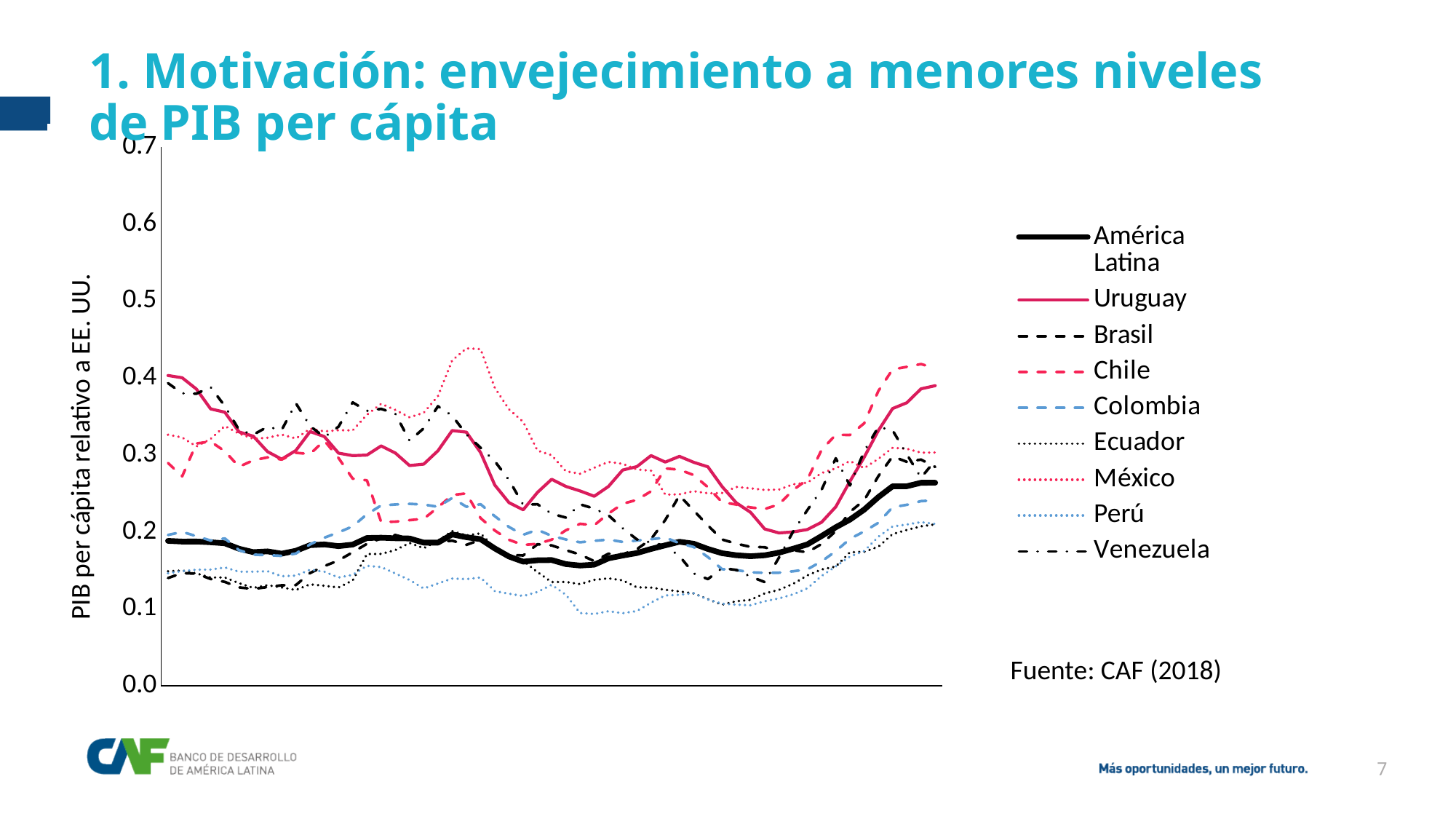
At the right end of the chart, which is higher, Chile or Perú? Chile Is the value for Chile at the right end of the chart greater or less than 0.3? greater Is the value for Uruguay at the left end of the chart greater or less than 0.3? greater Which series is drawn as the thick solid black line? América Latina Is the América Latina line higher or lower at the right end of the chart than at the left end? higher Is the value for América Latina at the right end of the chart greater or less than 0.3? less What kind of chart is shown on the slide? line chart What is the label of the vertical axis? PIB per cápita relativo a EE. UU. How many series does the legend list? 9 Does the Uruguay line rise or fall over the final portion of the chart? rise